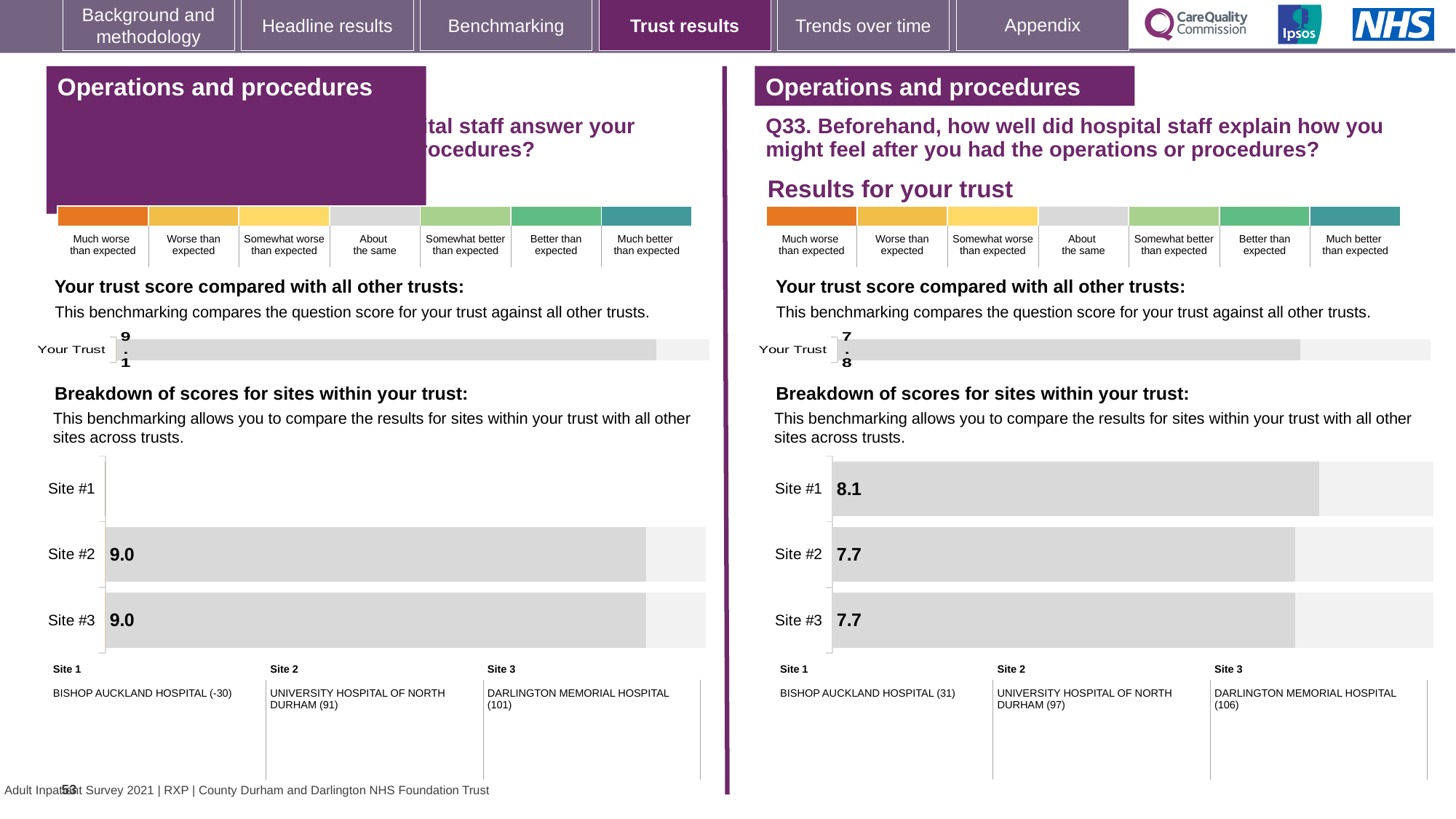
On the right-hand chart (Q33), is the score for Site #1 larger or smaller than the score for Site #3? larger On the right-hand chart (Q33), what is the score for Site #3? 7.7 On the left-hand chart, what is the score for Site #3? 9.0 On the left-hand chart, what is the score for Site #2? 9.0 On the right-hand chart (Q33), what is the score shown for Your Trust? 7.8 On the left-hand chart, what is the score shown for Your Trust? 9.1 On the right-hand chart (Q33), what is the score for Site #1? 8.1 On the right-hand chart (Q33), what is the score for Site #2? 7.7 On the right-hand chart (Q33), which site has the highest score? Site #1 On the right-hand chart (Q33), what is the difference between the scores for Site #1 and Site #2? 0.4 What type of chart is used to show the breakdown of scores for sites on the right-hand side (Q33)? bar chart How many sites are listed in the site breakdown chart on the right-hand side (Q33)? 3